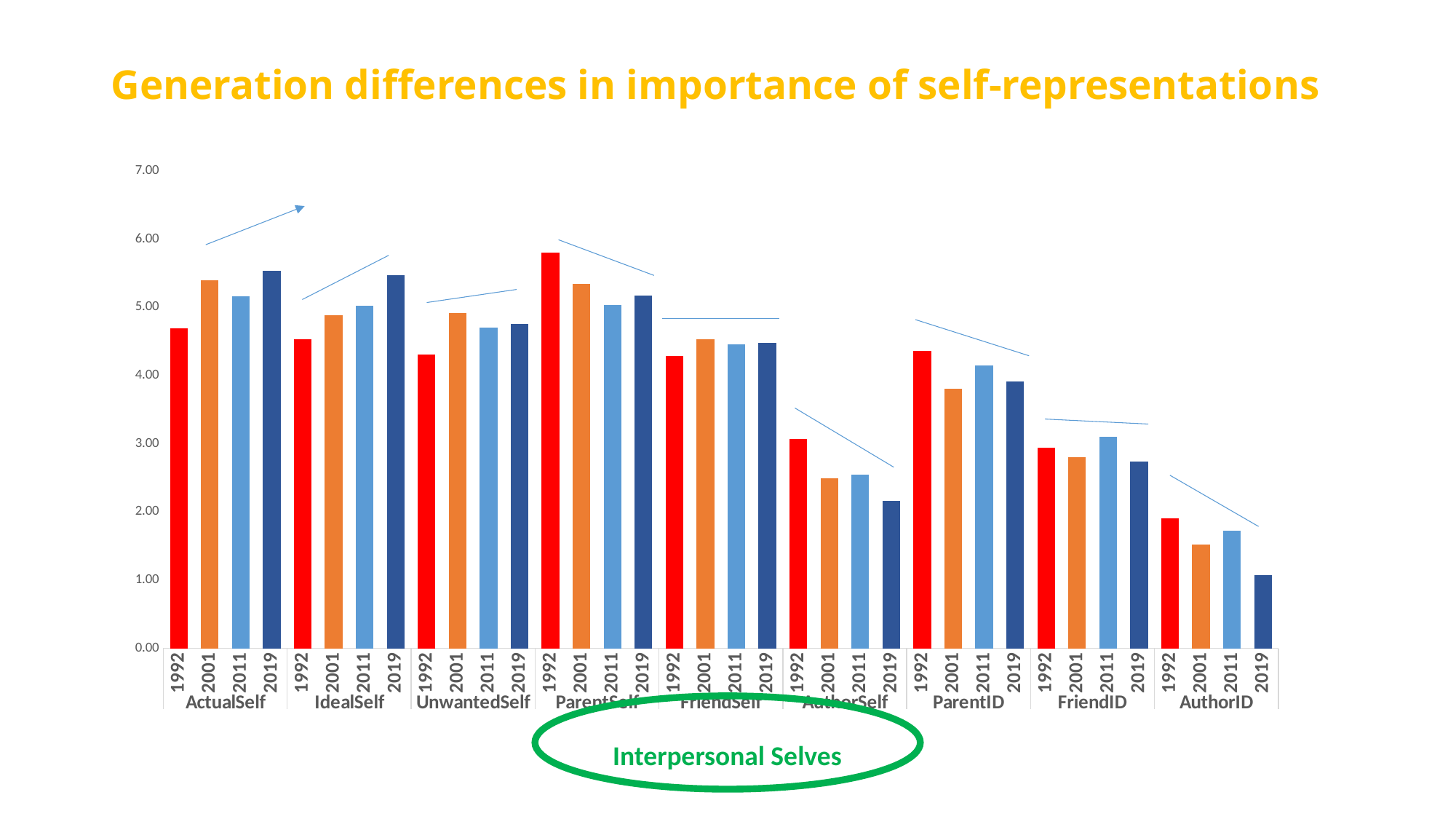
Which category and year has the shortest bar in the chart? AuthorID, 2019 Is the value for UnwantedSelf in 1992 greater or less than 5.00? less Which category and year has the tallest bar in the chart? ParentSelf, 1992 How many years (bars) are shown within each self-representation category? 4 Is the value for ParentID in 1992 greater or less than 4.00? greater Is the value for AuthorID in 2019 greater or less than 2.00? less For ActualSelf, which is larger: the 1992 bar or the 2019 bar? 2019 What kind of chart is shown on the slide? bar chart Which is larger for 1992: ParentID or FriendID? ParentID How many self-representation categories are shown along the x axis? 9 What text is written inside the green oval below the chart? Interpersonal Selves